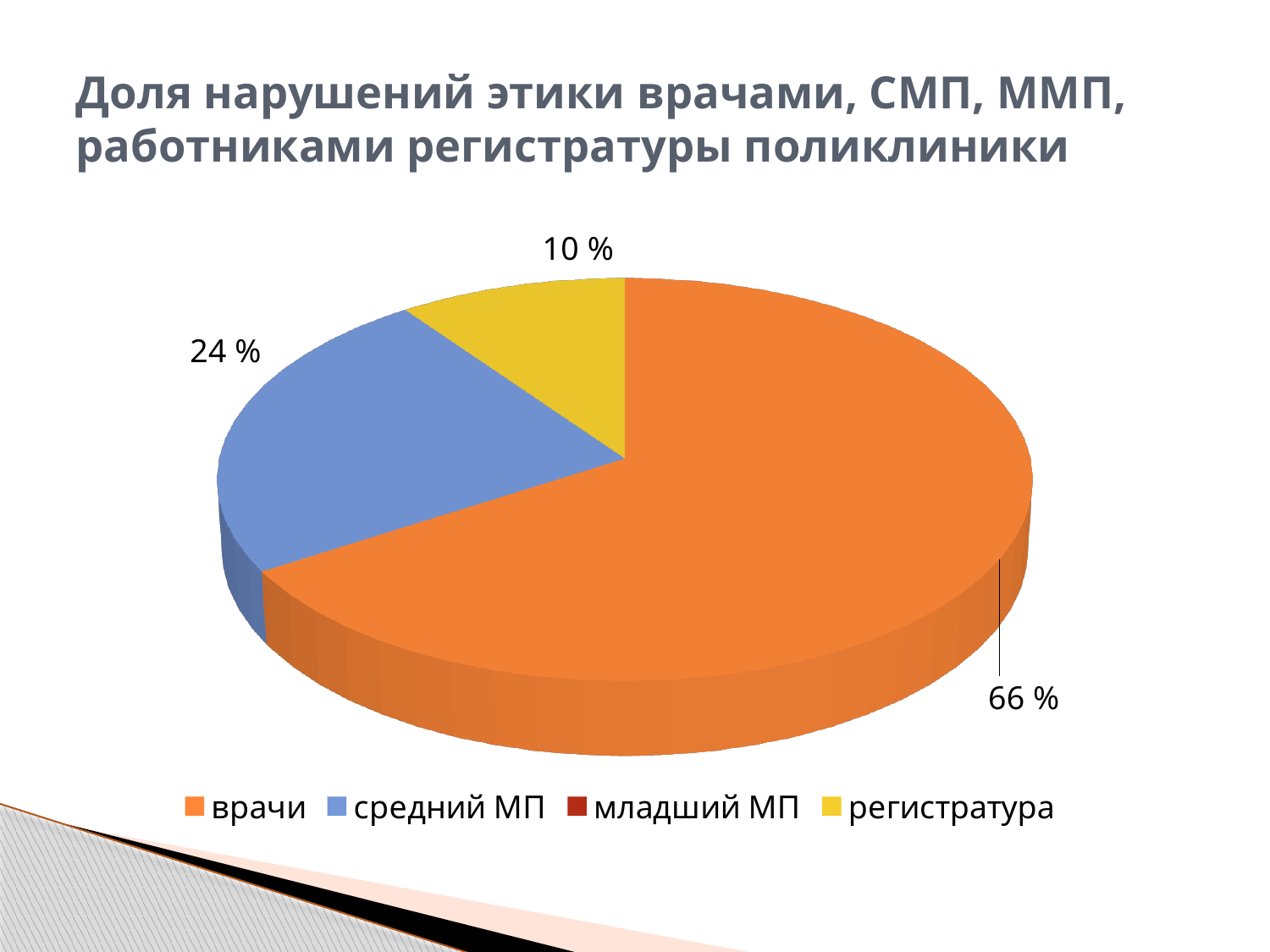
How many entries does the legend list? 4 What share of the pie is labelled for средний МП? 24 % By how many percentage points does the врачи slice exceed the средний МП slice? 42 Which legend entry is shown in yellow? регистратура Which category has the largest slice of the pie? врачи What kind of chart is shown on the slide? Pie chart Which of the labelled slices is the smallest? регистратура What colour is the врачи slice? Orange How many slices have a percentage label on the chart? 3 What share of the pie is labelled for регистратура? 10 % Which slice is larger, средний МП or регистратура? средний МП What share of the pie is labelled for врачи? 66 %